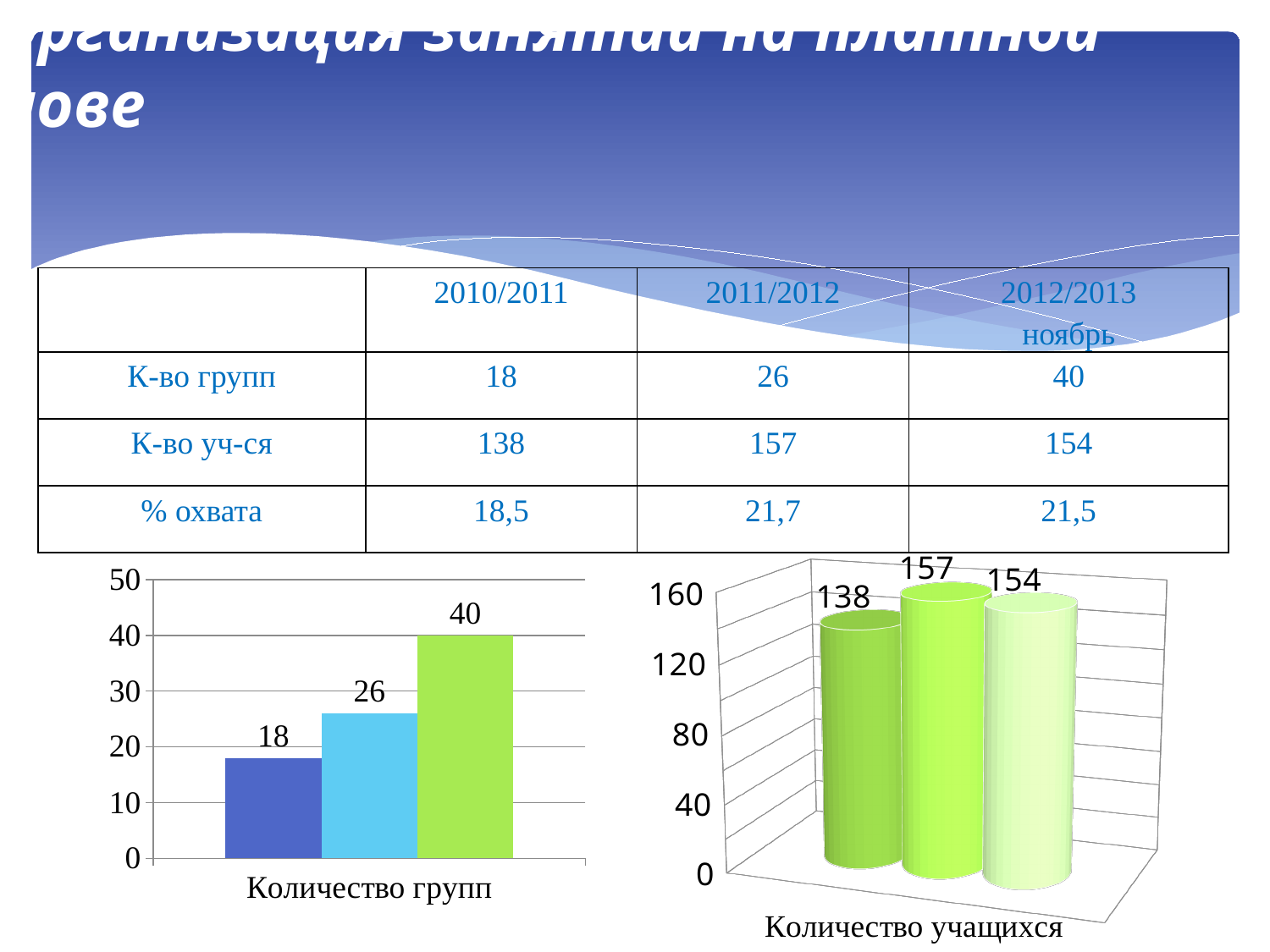
In the left chart titled "Количество групп", do the values rise or fall from left to right? rise How many bars are plotted in the left chart titled "Количество групп"? 3 In the left chart titled "Количество групп", which bar is the highest? the third (rightmost) bar In the right chart titled "Количество учащихся", which bar is the lowest? the first (leftmost) bar In the left chart titled "Количество групп", is the second bar larger or smaller than the third bar? smaller In the right chart titled "Количество учащихся", what is the value of the middle bar? 157 In the right chart titled "Количество учащихся", what is the value of the first (leftmost) bar? 138 In the left chart titled "Количество групп", what is the difference between the third bar and the first bar? 22 In the right chart titled "Количество учащихся", what is the difference between the middle bar and the rightmost bar? 3 In the left chart titled "Количество групп", what is the value of the third (rightmost) bar? 40 What kind of chart is the right chart titled "Количество учащихся"? bar chart In the left chart titled "Количество групп", what is the value of the first (leftmost) bar? 18